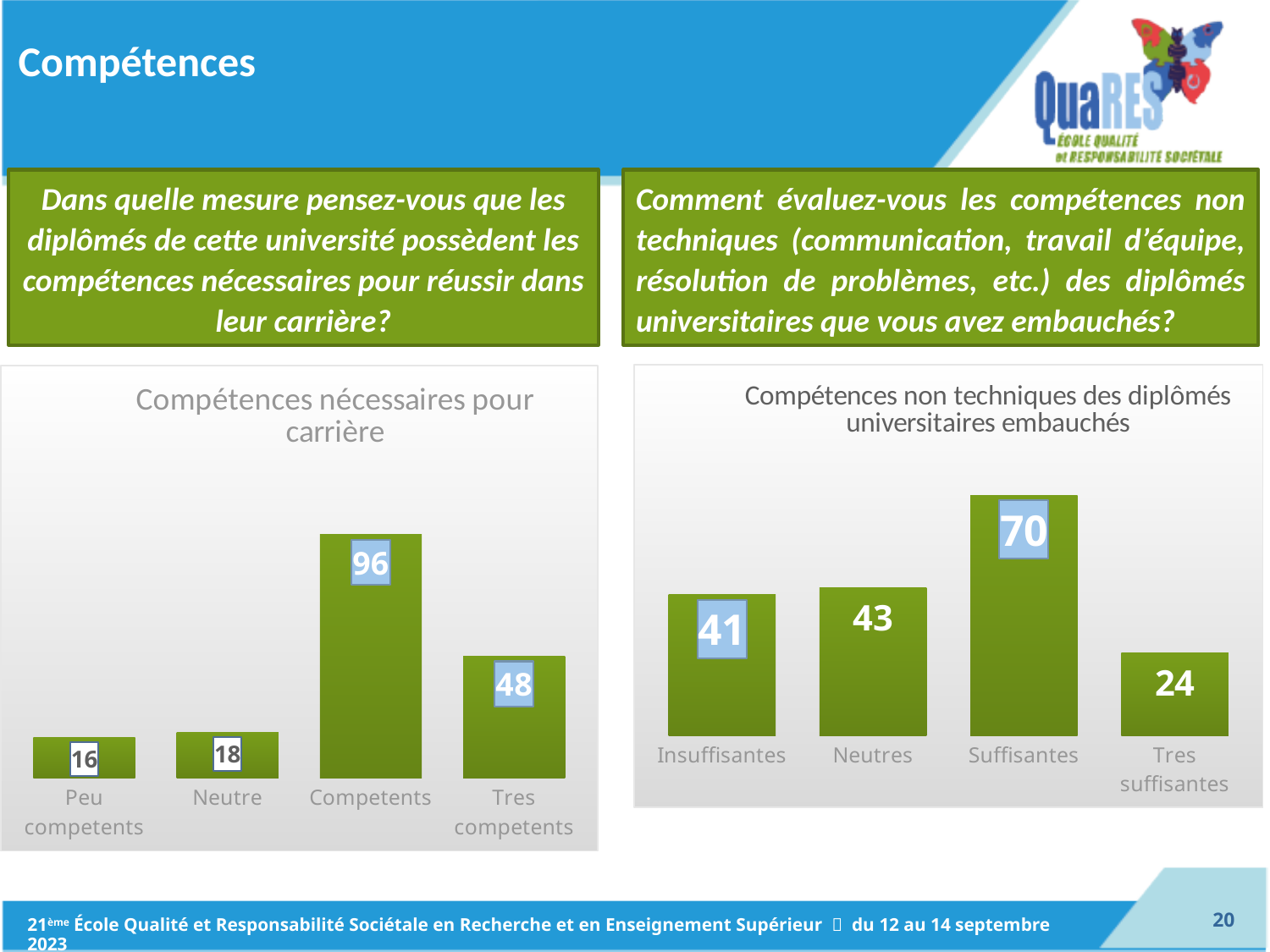
In the chart 'Compétences nécessaires pour carrière', what is the difference between the values for Competents and Tres competents? 48 In the chart 'Compétences nécessaires pour carrière', which category has the lowest value? Peu competents In the chart 'Compétences nécessaires pour carrière', how many categories are shown? 4 In the chart 'Compétences nécessaires pour carrière', what is the value for Peu competents? 16 In the chart 'Compétences non techniques des diplômés universitaires embauchés', what is the value for Suffisantes? 70 In the chart 'Compétences non techniques des diplômés universitaires embauchés', which category has the lowest value? Tres suffisantes In the chart 'Compétences nécessaires pour carrière', what is the value for Competents? 96 What type of chart is the chart on the right of the slide? Bar chart In the chart 'Compétences non techniques des diplômés universitaires embauchés', what is the value for Tres suffisantes? 24 In the chart 'Compétences nécessaires pour carrière', which category has the highest value? Competents In the chart 'Compétences non techniques des diplômés universitaires embauchés', what is the difference between the values for Neutres and Insuffisantes? 2 In the chart 'Compétences non techniques des diplômés universitaires embauchés', which is larger, the value for Suffisantes or the value for Neutres? Suffisantes